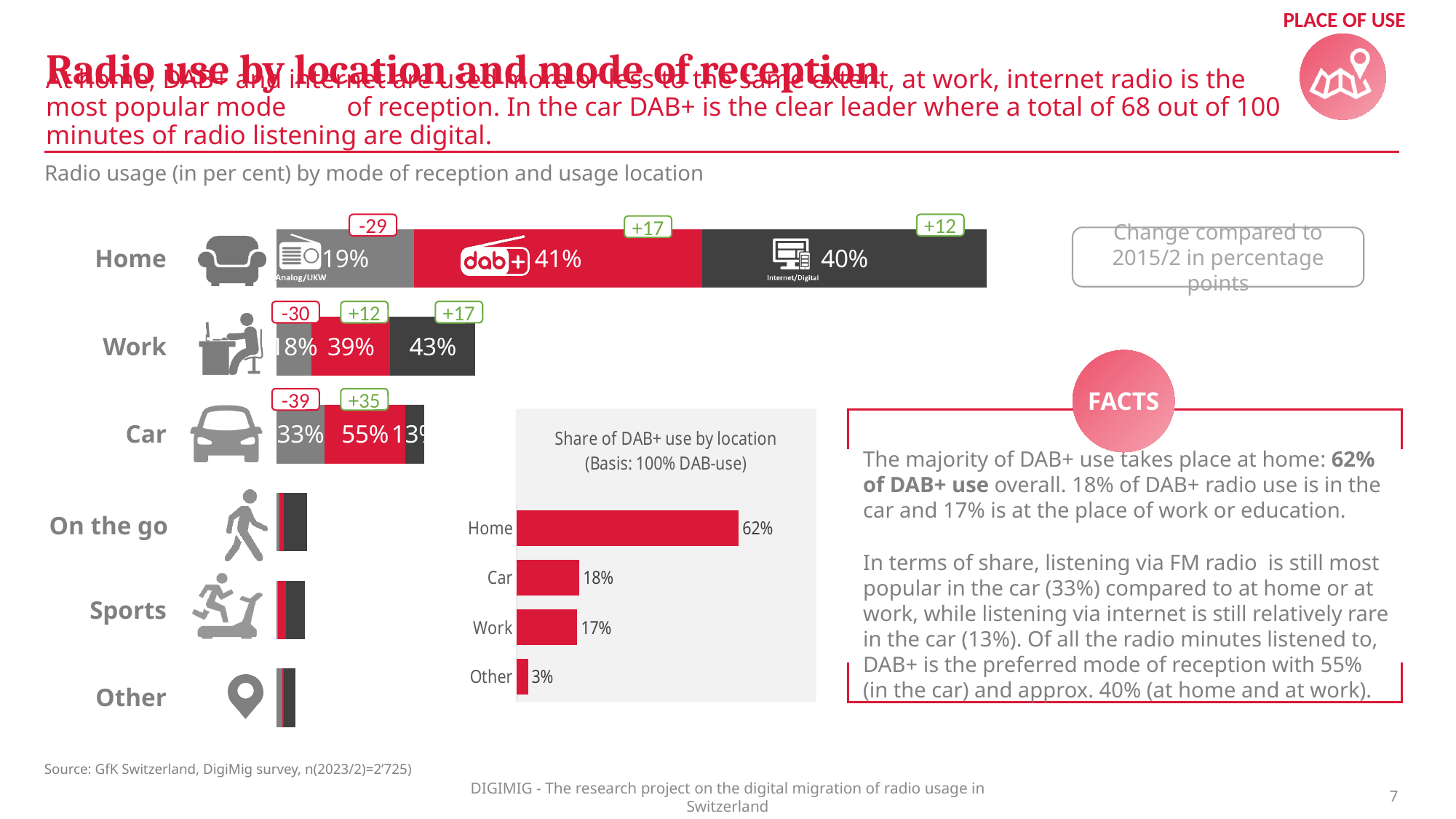
In the 'Share of DAB+ use by location' chart, which is larger, Car or Work? Car In the 'Radio usage by mode of reception and usage location' chart, what is the DAB+ share at Home? 41% How many locations are shown in the 'Share of DAB+ use by location' chart? 4 In the 'Share of DAB+ use by location' chart, which location has the lowest share? Other In the 'Radio usage by mode of reception and usage location' chart, what is the total of the three segments of the Home bar? 100% In the 'Radio usage by mode of reception and usage location' chart, which location has the highest DAB+ share? Car In the 'Share of DAB+ use by location' chart, what is the value for Home? 62% What kind of chart is the 'Share of DAB+ use by location' chart? Bar chart In the 'Radio usage by mode of reception and usage location' chart, what is the change compared to 2015/2 for DAB+ in the Car? +35 In the 'Radio usage by mode of reception and usage location' chart, what is the Internet/Digital share at Work? 43% In the 'Share of DAB+ use by location' chart, what is the difference between the Home and Car values? 44 percentage points In the 'Radio usage by mode of reception and usage location' chart, what is the Analog/UKW share in the Car? 33%